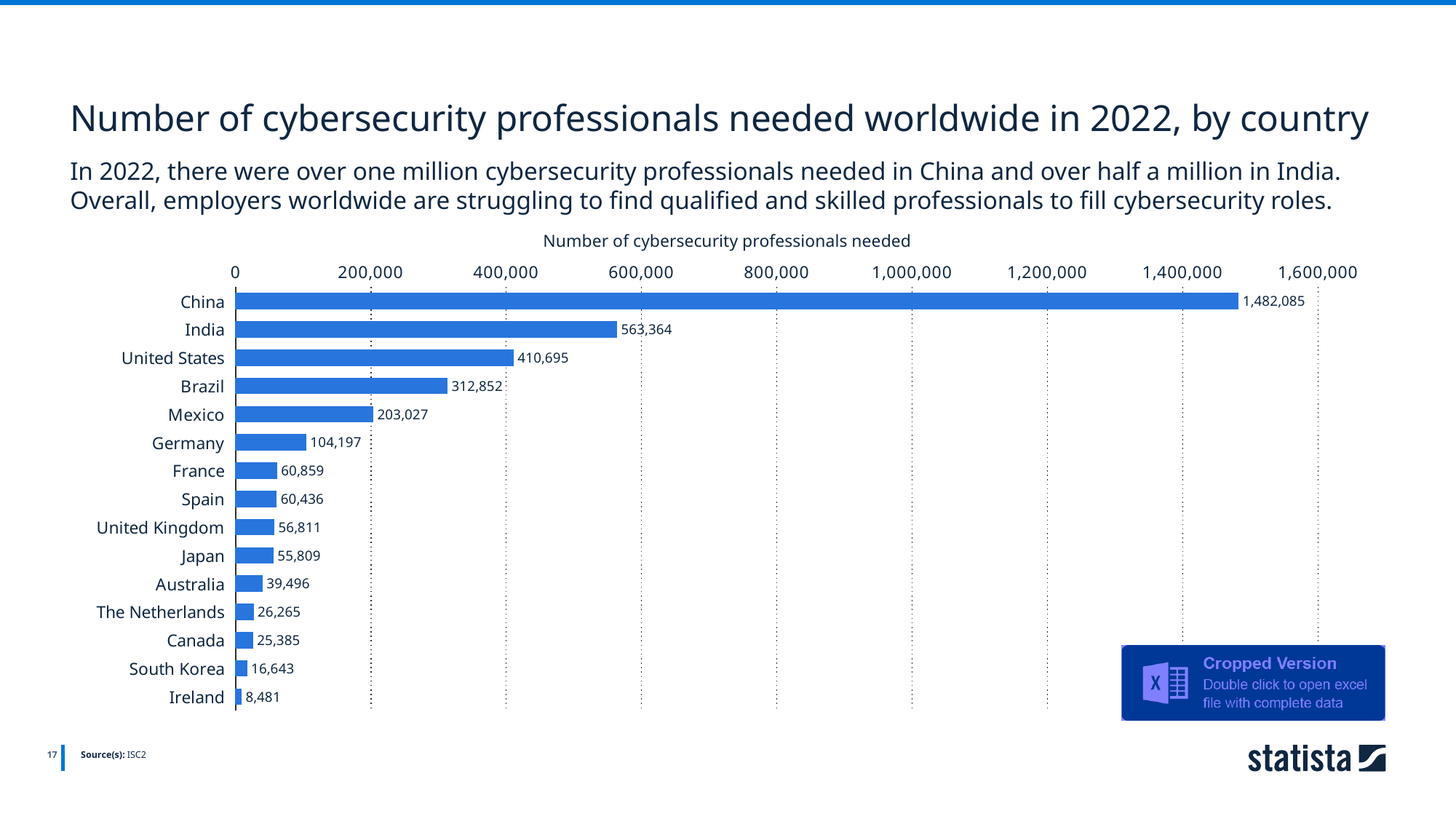
Which country has the lowest number of cybersecurity professionals needed? Ireland How many countries are shown in the chart? 15 What is the number of cybersecurity professionals needed in China? 1,482,085 What is the number of cybersecurity professionals needed in Japan? 55,809 What is the number of cybersecurity professionals needed in the United States? 410,695 What kind of chart is shown on the slide? Bar chart Which country needs more cybersecurity professionals, Brazil or Mexico? Brazil What is the difference between the number of cybersecurity professionals needed in the United States and in Brazil? 97,843 What is the difference between the number of cybersecurity professionals needed in China and in India? 918,721 What is the title of the chart's axis label shown above the bars? Number of cybersecurity professionals needed Is the value for Germany greater or less than 200,000? less Which country has the highest number of cybersecurity professionals needed? China